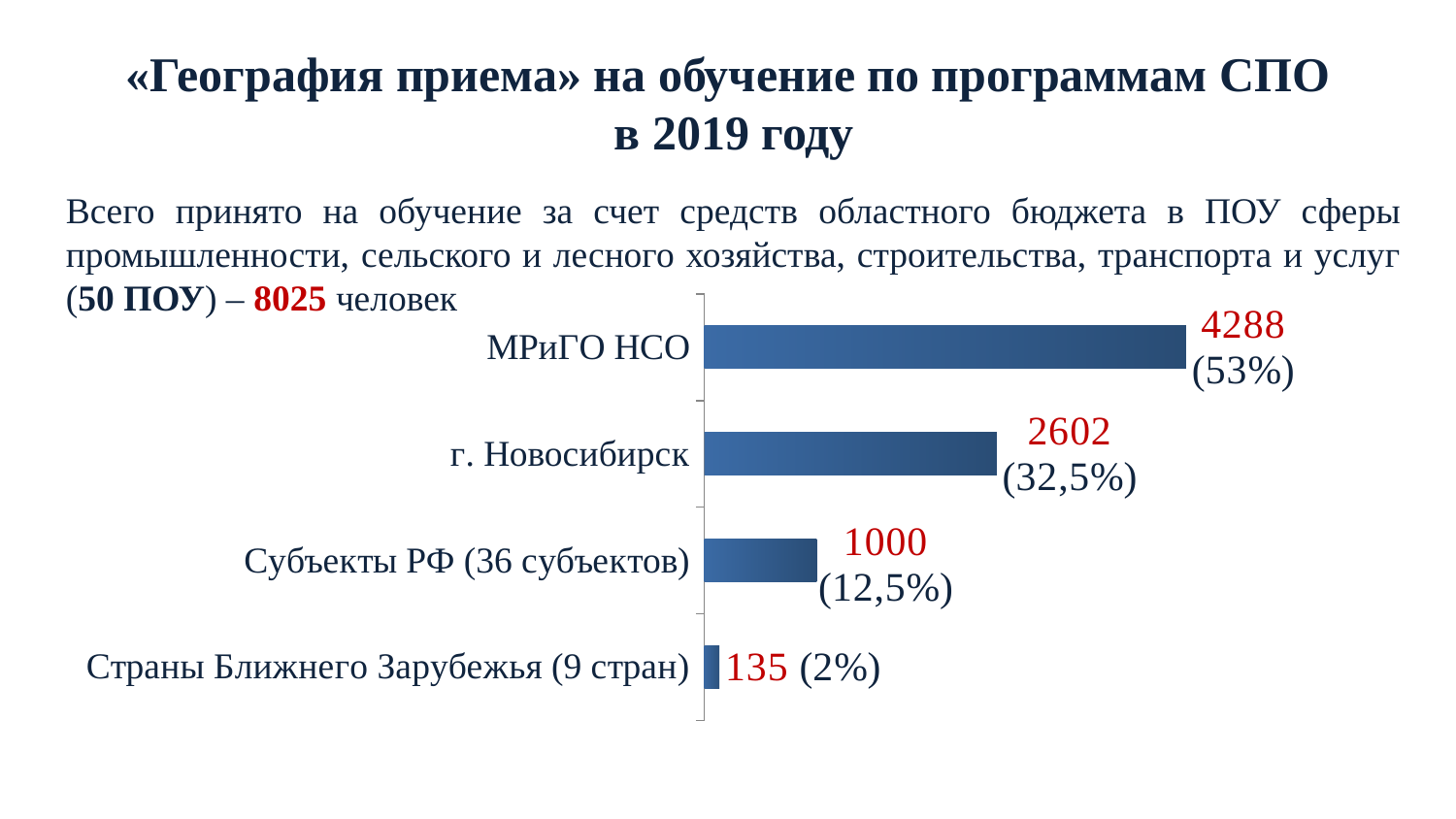
How many categories are shown in the chart? 4 What percentage is shown next to the bar for г. Новосибирск? 32,5% What value is shown for МРиГО НСО? 4288 Which category has the highest value? МРиГО НСО What value is shown for Страны Ближнего Зарубежья (9 стран)? 135 What value is shown for г. Новосибирск? 2602 Which is larger, the value for г. Новосибирск or the value for Субъекты РФ (36 субъектов)? г. Новосибирск What is the difference between the values for Субъекты РФ (36 субъектов) and Страны Ближнего Зарубежья (9 стран)? 865 What is the difference between the values for МРиГО НСО and г. Новосибирск? 1686 Which category has the lowest value? Страны Ближнего Зарубежья (9 стран) What kind of chart is shown on the slide? bar chart What value is shown for Субъекты РФ (36 субъектов)? 1000